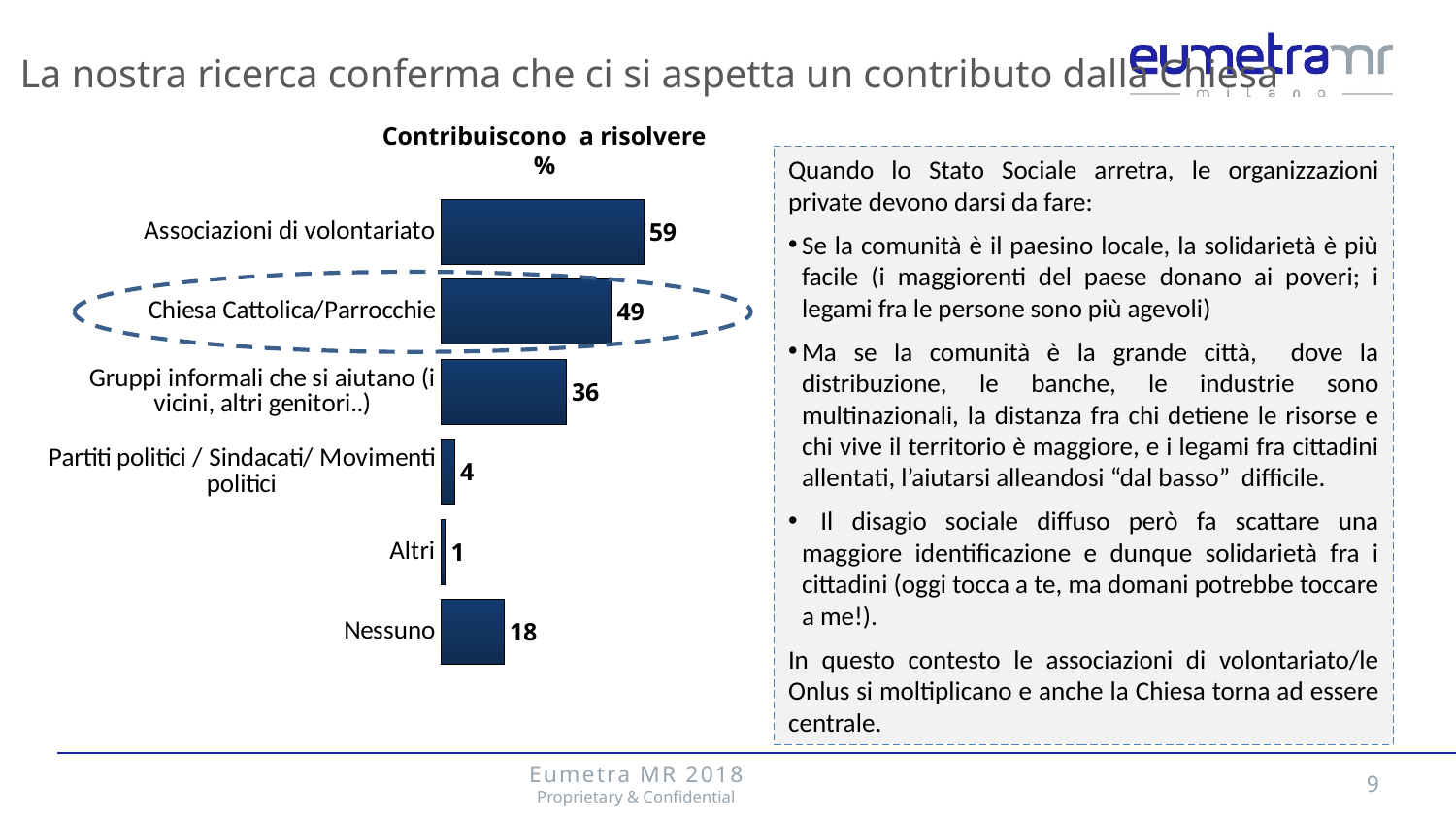
Which is larger, the value for Gruppi informali che si aiutano or the value for Nessuno? Gruppi informali che si aiutano Which category has the lowest value? Altri What is the value for Altri? 1 What is the value for Nessuno? 18 What is the difference between the values for Nessuno and Partiti politici / Sindacati/ Movimenti politici? 14 How many categories are shown in the chart? 6 What is the value for Chiesa Cattolica/Parrocchie? 49 Which category has the highest value? Associazioni di volontariato What is the difference between the values for Associazioni di volontariato and Chiesa Cattolica/Parrocchie? 10 What is the value for Associazioni di volontariato? 59 What is the title of the chart? Contribuiscono a risolvere % What kind of chart is shown on the slide? Bar chart